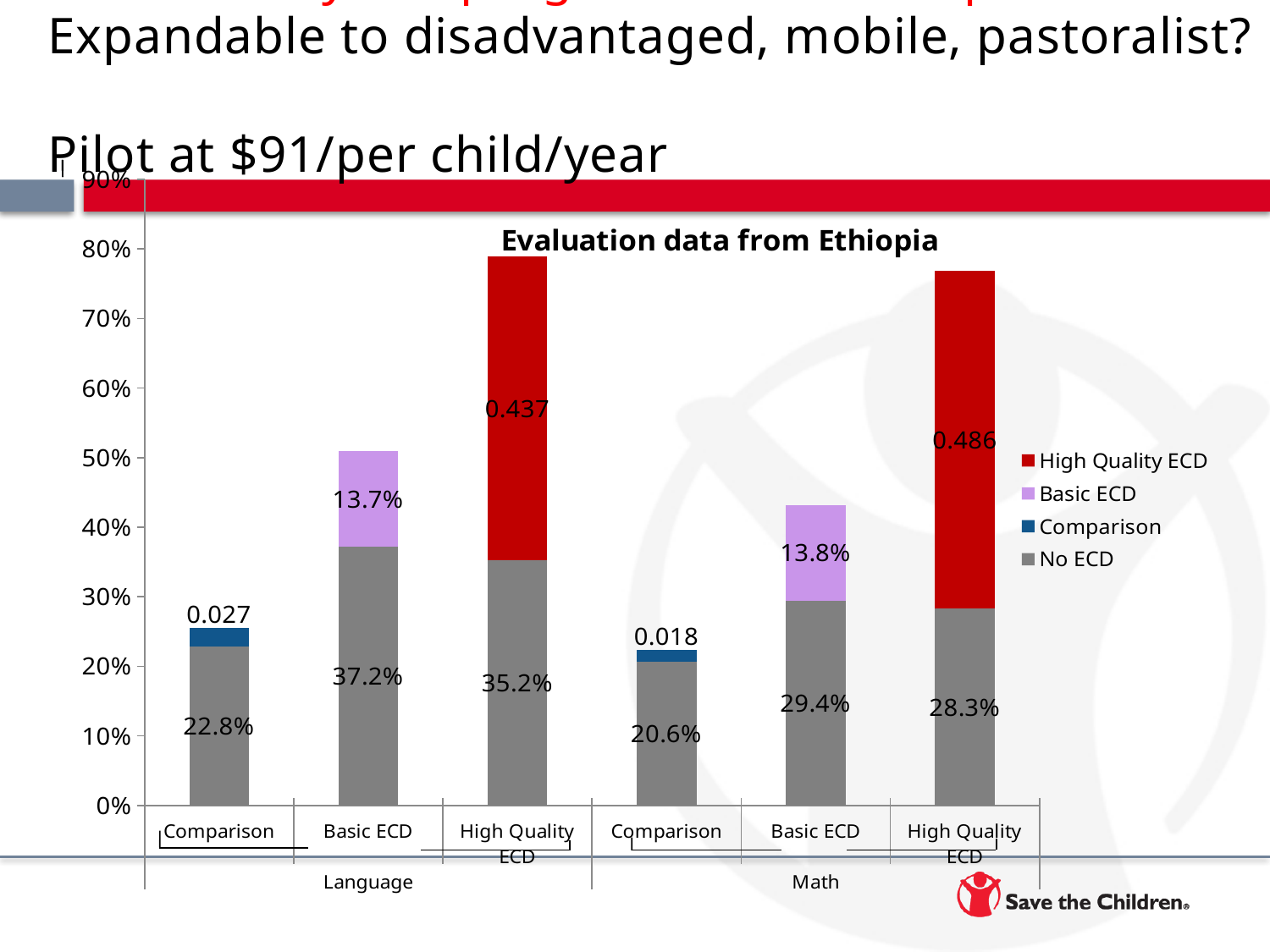
How many series does the legend list? 4 What is the Comparison value for the Comparison group under Language? 0.027 How many bars are plotted in the chart? 6 Is the total height of the High Quality ECD bar under Language greater or less than 70%? greater What is the No ECD value for the Comparison group under Language? 22.8% What is the Basic ECD value for the Basic ECD group under Math? 13.8% Which group has the lowest No ECD value? Comparison (Math) Which group has the highest No ECD value? Basic ECD (Language) What is the High Quality ECD value for the High Quality ECD group under Math? 0.486 What is the total of the stacked bar for Basic ECD under Language? 50.9% Which is larger: the High Quality ECD value under Language or under Math? Math What is the difference between the No ECD values for Basic ECD and High Quality ECD under Language? 2.0%